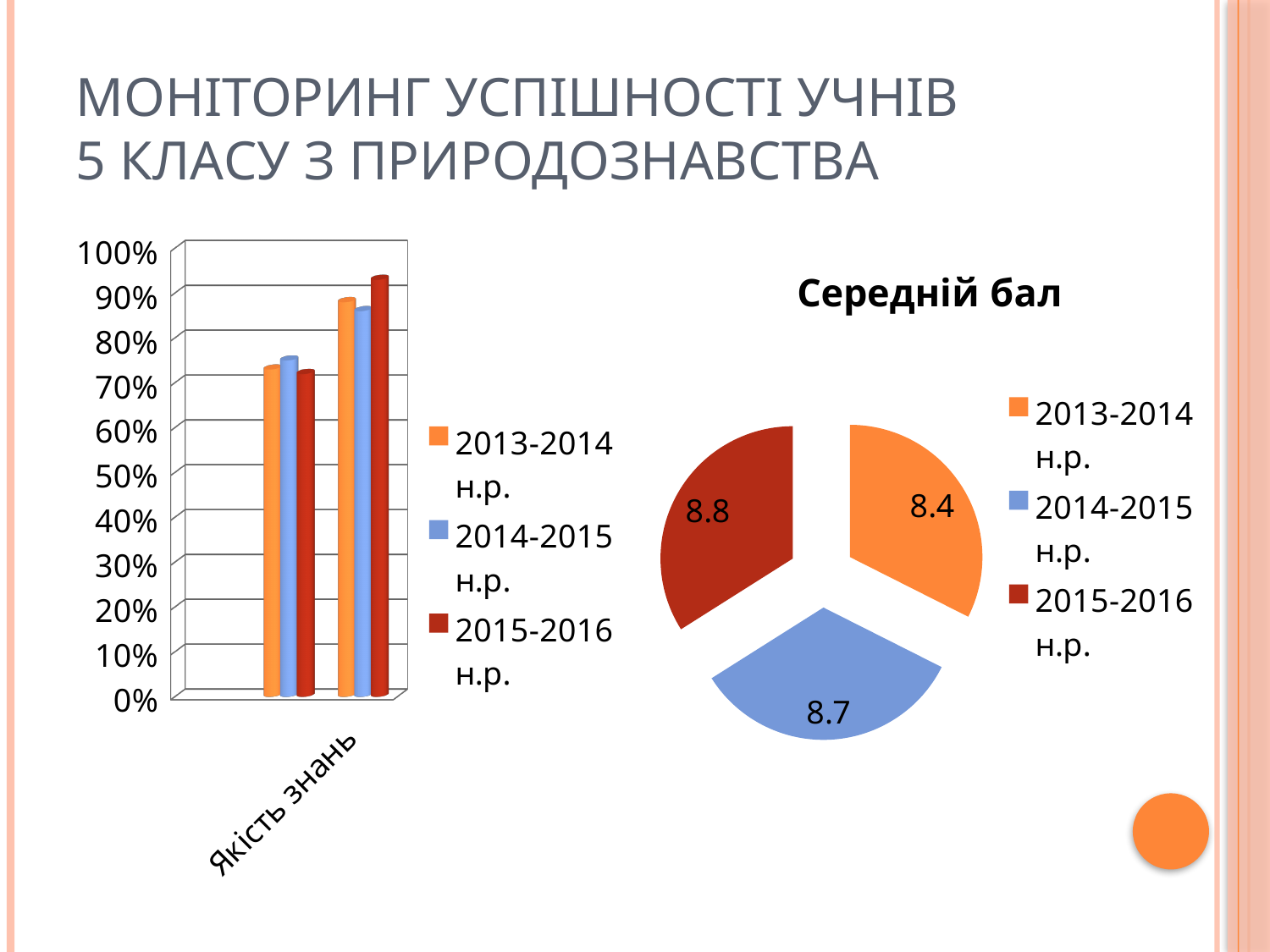
In the pie chart titled "Середній бал", which school year has the lowest value? 2013-2014 н.р. How many slices does the pie chart titled "Середній бал" have? 3 In the bar chart on the left, is the value for 2014-2015 н.р. in the "Якість знань" category greater or less than 80%? greater In the pie chart titled "Середній бал", what is the difference between the values for 2015-2016 н.р. and 2013-2014 н.р.? 0.4 In the pie chart titled "Середній бал", which school year has the highest value? 2015-2016 н.р. In the bar chart on the left, is the value for 2014-2015 н.р. in the "Якість знань" category greater or less than 70%? greater In the pie chart titled "Середній бал", what is the value for 2013-2014 н.р.? 8.4 In the pie chart titled "Середній бал", what is the value for 2015-2016 н.р.? 8.8 In the pie chart titled "Середній бал", which is larger: the value for 2014-2015 н.р. or for 2013-2014 н.р.? 2014-2015 н.р. What kind of chart is the chart on the left side of the slide? Bar chart How many series does the legend of the bar chart on the left list? 3 In the pie chart titled "Середній бал", what is the value for 2014-2015 н.р.? 8.7